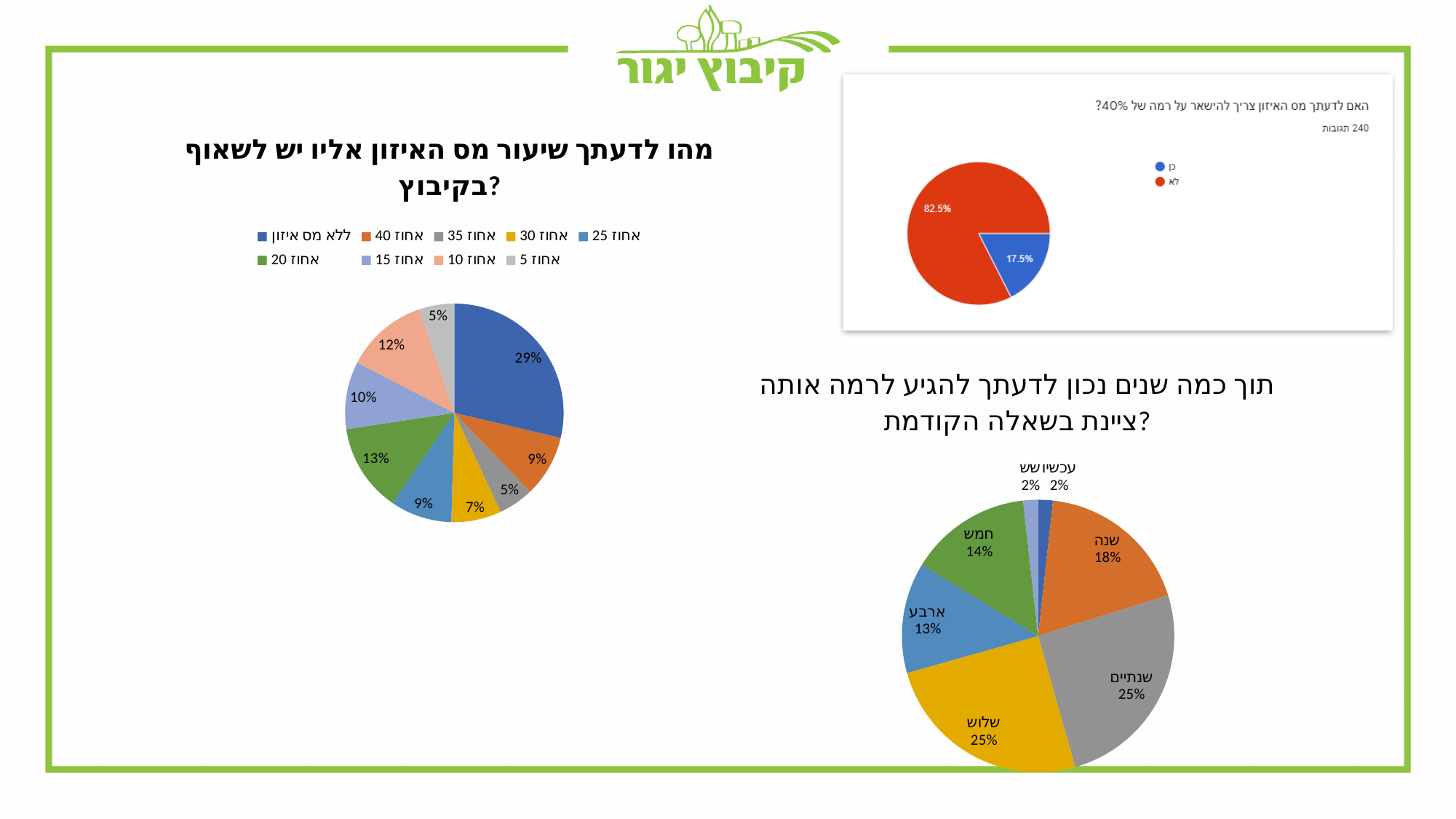
In the bottom-right pie chart, which is larger: the share for חמש or the share for ארבע? חמש In the bottom-right pie chart (תוך כמה שנים נכון לדעתך להגיע לרמה אותה ציינת בשאלה הקודמת?), what is the share for ארבע? 13% What type of chart is used for the bottom-right chart (תוך כמה שנים נכון לדעתך להגיע לרמה אותה ציינת בשאלה הקודמת?)? Pie chart How many categories does the legend of the left pie chart (מהו לדעתך שיעור מס האיזון אליו יש לשאוף בקיבוץ?) list? 9 In the left pie chart (מהו לדעתך שיעור מס האיזון אליו יש לשאוף בקיבוץ?), which category has the largest share? ללא מס איזון In the left pie chart (מהו לדעתך שיעור מס האיזון אליו יש לשאוף בקיבוץ?), what is the share for ללא מס איזון? 29% In the top-right pie chart (האם לדעתך מס האיזון צריך להישאר על רמה של 40%?), what share of respondents answered לא? 82.5% In the top-right pie chart (האם לדעתך מס האיזון צריך להישאר על רמה של 40%?), what share of respondents answered כן? 17.5% In the bottom-right pie chart (תוך כמה שנים נכון לדעתך להגיע לרמה אותה ציינת בשאלה הקודמת?), what is the share for שנה? 18% In the left pie chart, what is the difference between the share for 10 אחוז and the share for 5 אחוז? 7% In the top-right pie chart, how many responses (תגובות) are reported? 240 In the left pie chart (מהו לדעתך שיעור מס האיזון אליו יש לשאוף בקיבוץ?), what is the share for 20 אחוז? 13%